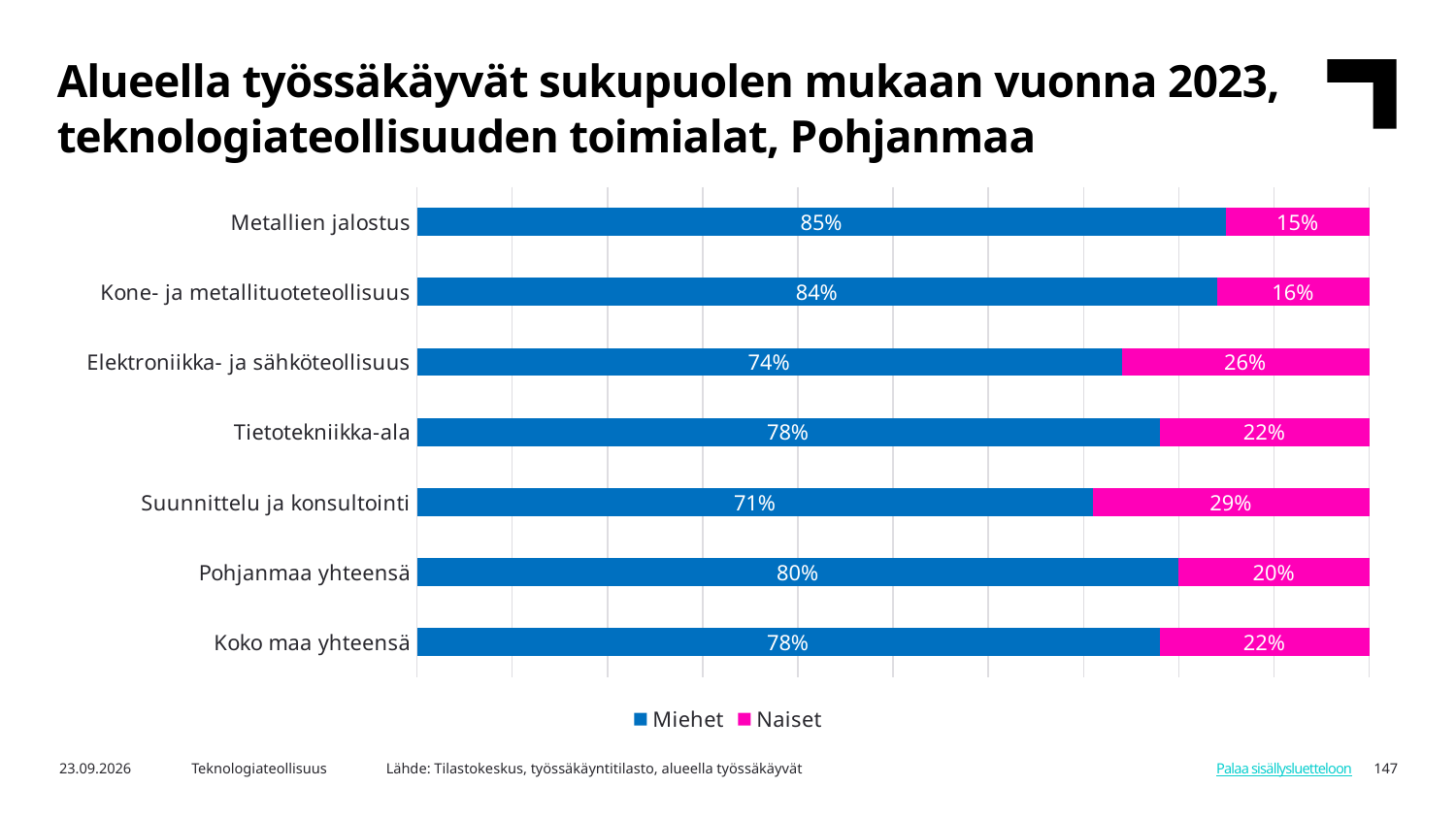
Which category has the highest Naiset share? Suunnittelu ja konsultointi What is the total of the stacked bar for Koko maa yhteensä? 100% Which category has the lowest Miehet share? Suunnittelu ja konsultointi What is the Naiset share for Suunnittelu ja konsultointi? 29% What is the difference between the Miehet share for Metallien jalostus and for Elektroniikka- ja sähköteollisuus? 11 percentage points Which colour represents Naiset in the chart? Pink (magenta) What is the Miehet share for Metallien jalostus? 85% How many series does the legend list? 2 Which is larger: the Naiset share for Tietotekniikka-ala or for Kone- ja metallituoteteollisuus? Tietotekniikka-ala What kind of chart is shown on the slide? Stacked bar chart What is the Naiset share for Pohjanmaa yhteensä? 20% How many categories are shown on the chart? 7